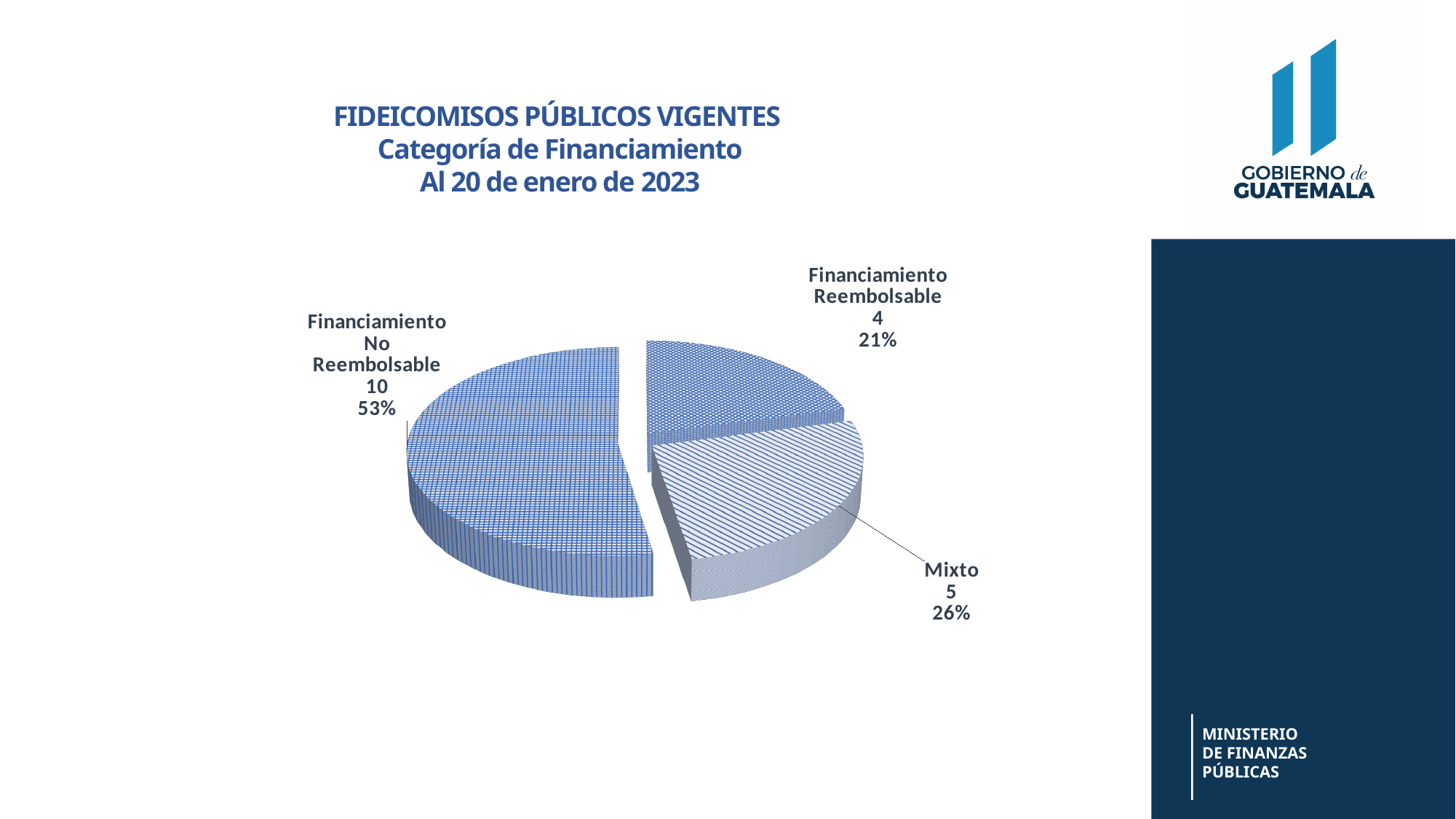
What percentage share does Financiamiento Reembolsable have? 21% What kind of chart is shown on the slide? Pie chart Which category has the smallest number of public trusts? Financiamiento Reembolsable How many public trusts are in the Financiamiento No Reembolsable category? 10 Which has more public trusts, Mixto or Financiamiento Reembolsable? Mixto What percentage share does Mixto have? 26% What is the difference in count between Financiamiento No Reembolsable and Mixto? 5 How many categories are shown in the pie chart? 3 Which category has the largest number of public trusts? Financiamiento No Reembolsable How many public trusts are in the Mixto category? 5 What is the date stated in the chart title? Al 20 de enero de 2023 What is the total number of public trusts across all three categories? 19